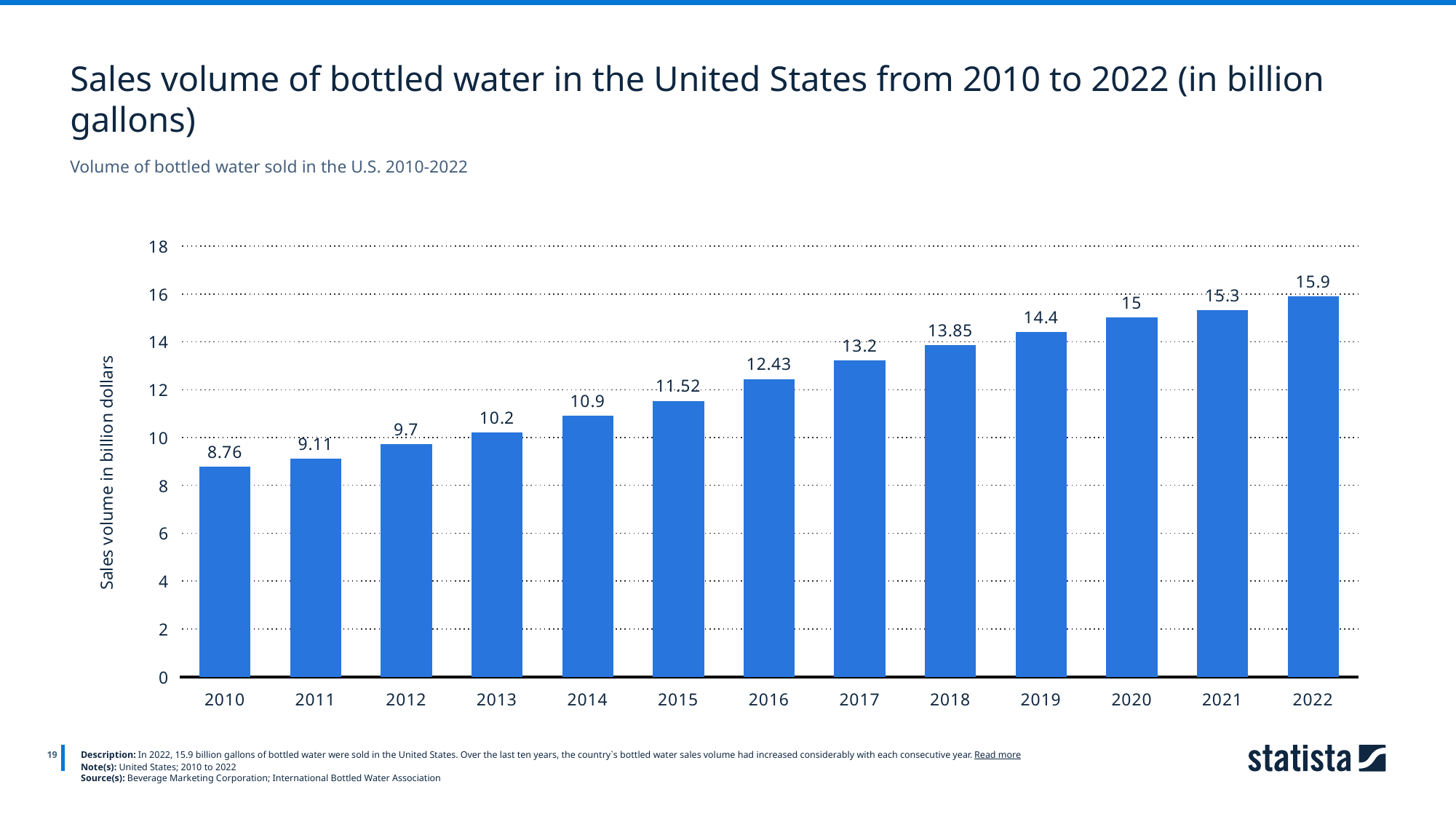
What kind of chart is shown on the slide? Bar chart Is the sales volume for 2019 greater or less than 14? greater What was the sales volume of bottled water in the United States in 2020? 15 Do the sales volumes rise or fall from 2010 to 2022? Rise Which year had the lowest sales volume of bottled water? 2010 What was the sales volume of bottled water in the United States in 2010? 8.76 Which year had a larger sales volume, 2013 or 2015? 2015 Which year had the highest sales volume of bottled water? 2022 How many years are shown on the chart? 13 What is the difference in sales volume between 2022 and 2010? 7.14 What was the sales volume of bottled water in the United States in 2016? 12.43 What is the difference in sales volume between 2018 and 2017? 0.65